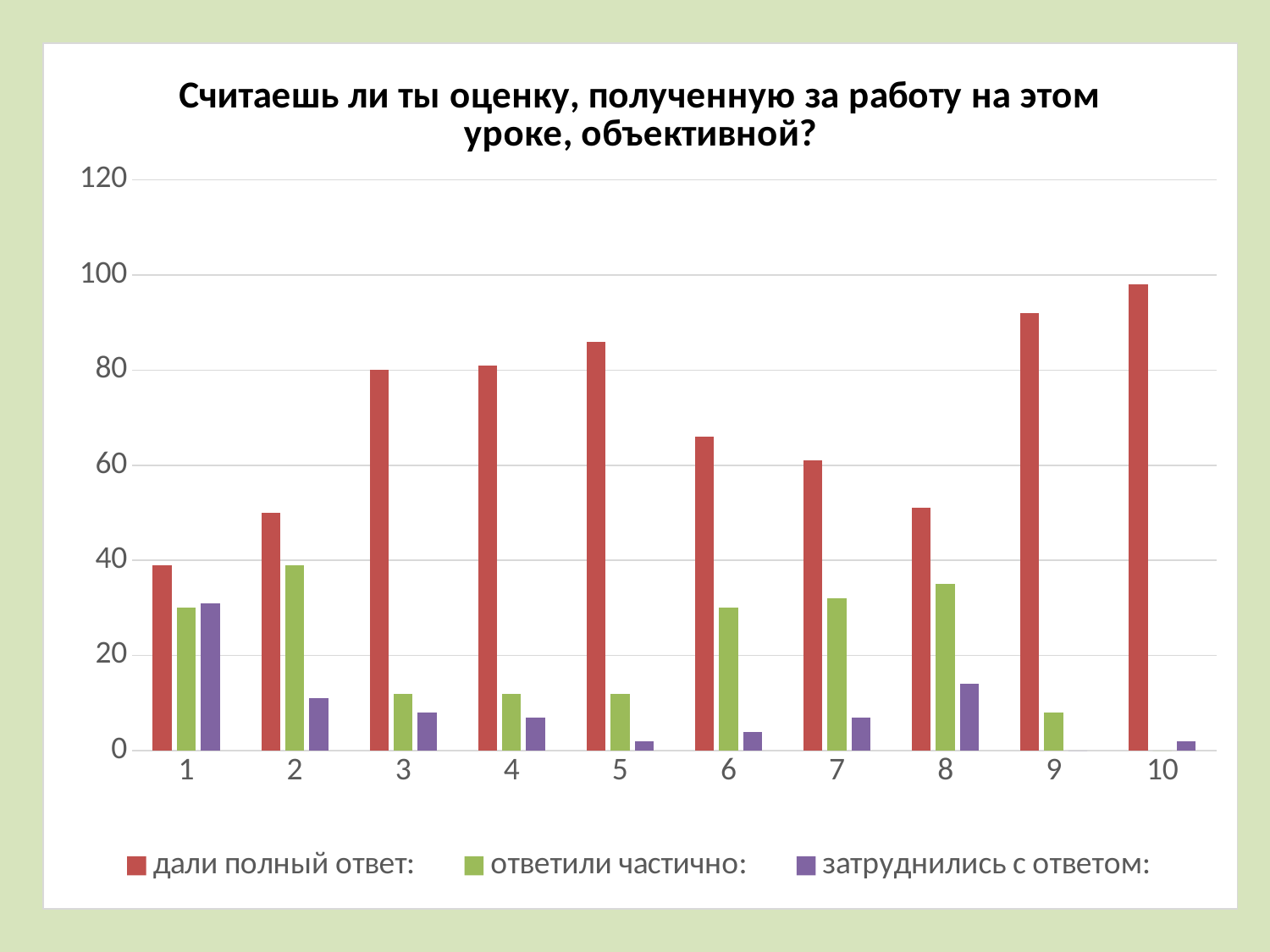
Which is larger for 'дали полный ответ:': category 8 or category 9? 9 Is the value for 'ответили частично:' in category 8 greater or less than 40? less Do the values for 'дали полный ответ:' rise or fall from category 1 to category 5? rise Which category has the highest value for 'затруднились с ответом:'? 1 How many categories are shown on the x axis? 10 Is the value for 'затруднились с ответом:' in category 1 greater or less than 20? greater What kind of chart is shown on the slide? bar chart Is the value for 'дали полный ответ:' in category 5 greater or less than 80? greater What is the title of the chart? Считаешь ли ты оценку, полученную за работу на этом уроке, объективной? Which category has the lowest value for 'дали полный ответ:'? 1 Which category has the highest value for 'дали полный ответ:'? 10 How many series does the legend list? 3